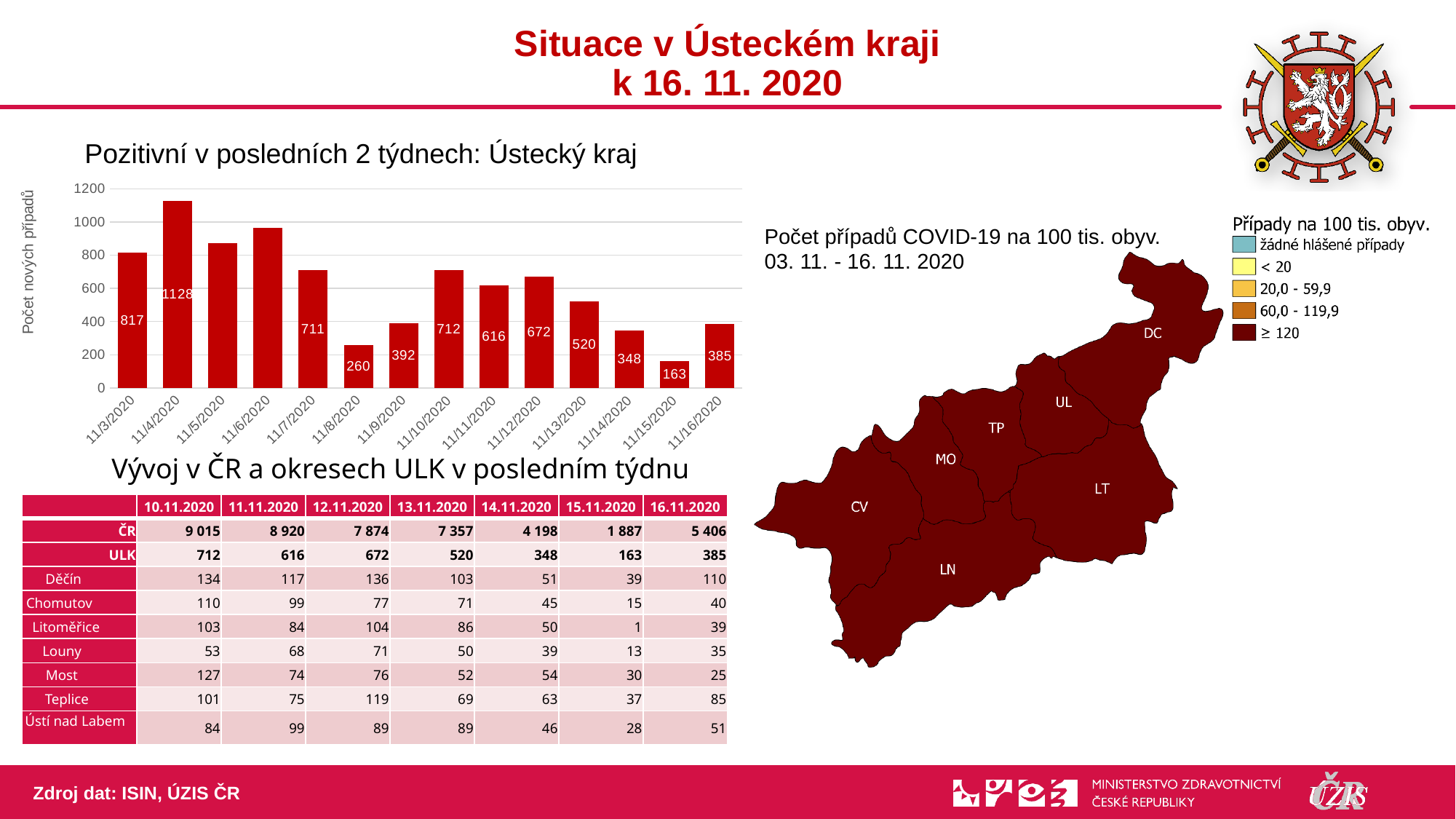
What is the difference between the values for 11/3/2020 and 11/15/2020 in the bar chart? 654 In the bar chart, what is the value for 11/16/2020? 385 Is the value for 11/6/2020 in the bar chart greater or less than 1000? less Which date has the highest bar in the chart? 11/4/2020 What is the label of the vertical axis of the bar chart? Počet nových případů In the bar chart, what is the value for 11/4/2020? 1128 In the bar chart, what is the value for 11/8/2020? 260 Which date has the lowest bar in the chart? 11/15/2020 What type of chart is used to show 'Pozitivní v posledních 2 týdnech: Ústecký kraj'? bar chart In the bar chart, which is larger: the value for 11/12/2020 or 11/13/2020? 11/12/2020 How many dates (bars) are shown in the bar chart? 14 Is the value for 11/5/2020 in the bar chart greater or less than 800? greater